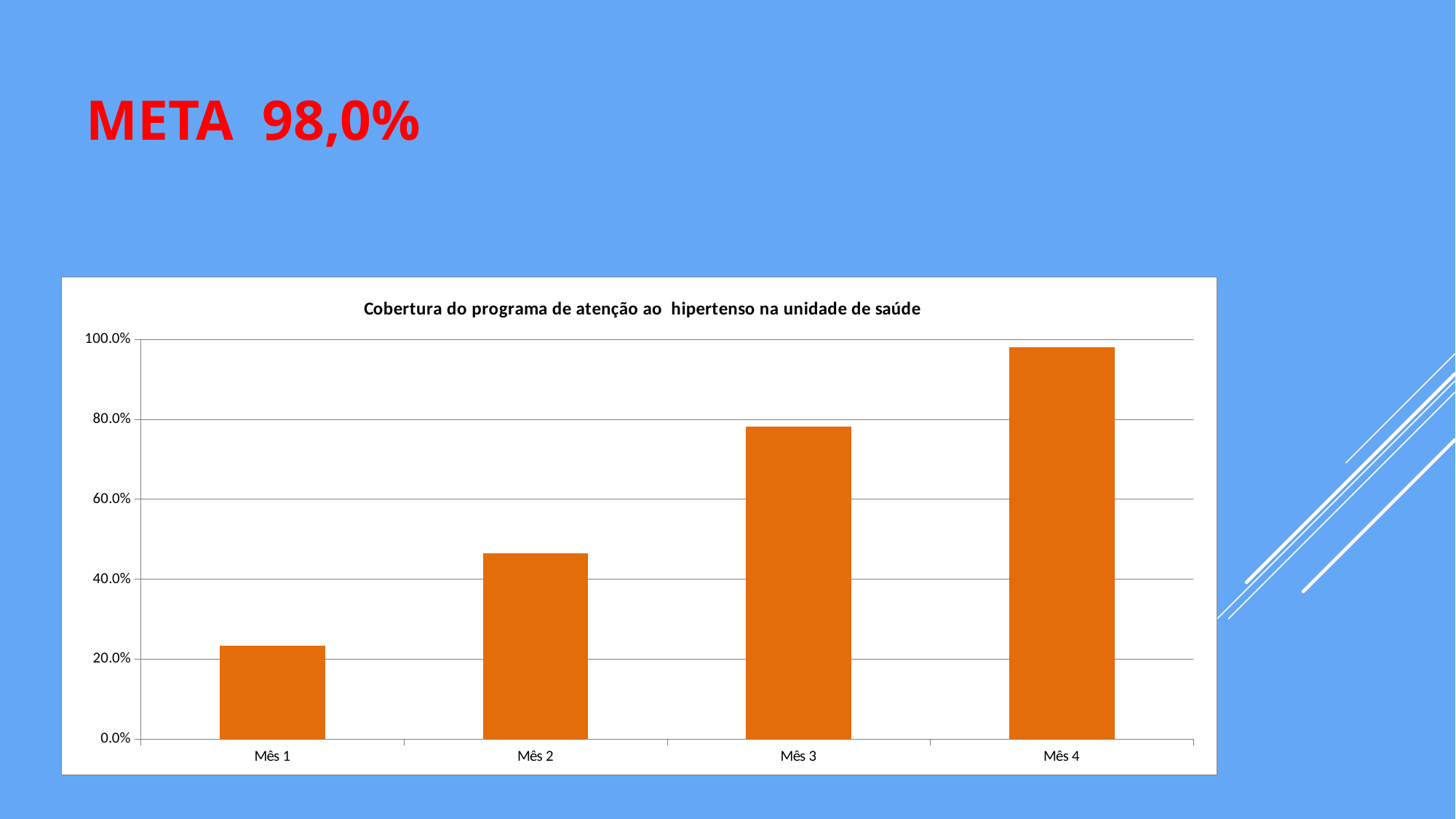
What colour are the bars in the chart? orange Which is larger, the value for Mês 2 or the value for Mês 3? Mês 3 Do the values rise or fall from Mês 1 to Mês 4? rise Is the value for Mês 1 greater or less than 40.0%? less Which month has the highest coverage value? Mês 4 Is the value for Mês 4 greater or less than 80.0%? greater How many categories (months) are plotted on the x axis? 4 Is the value for Mês 2 greater or less than 40.0%? greater What kind of chart is shown on the slide? bar chart Which month has the lowest coverage value? Mês 1 What is the title of the chart? Cobertura do programa de atenção ao hipertenso na unidade de saúde